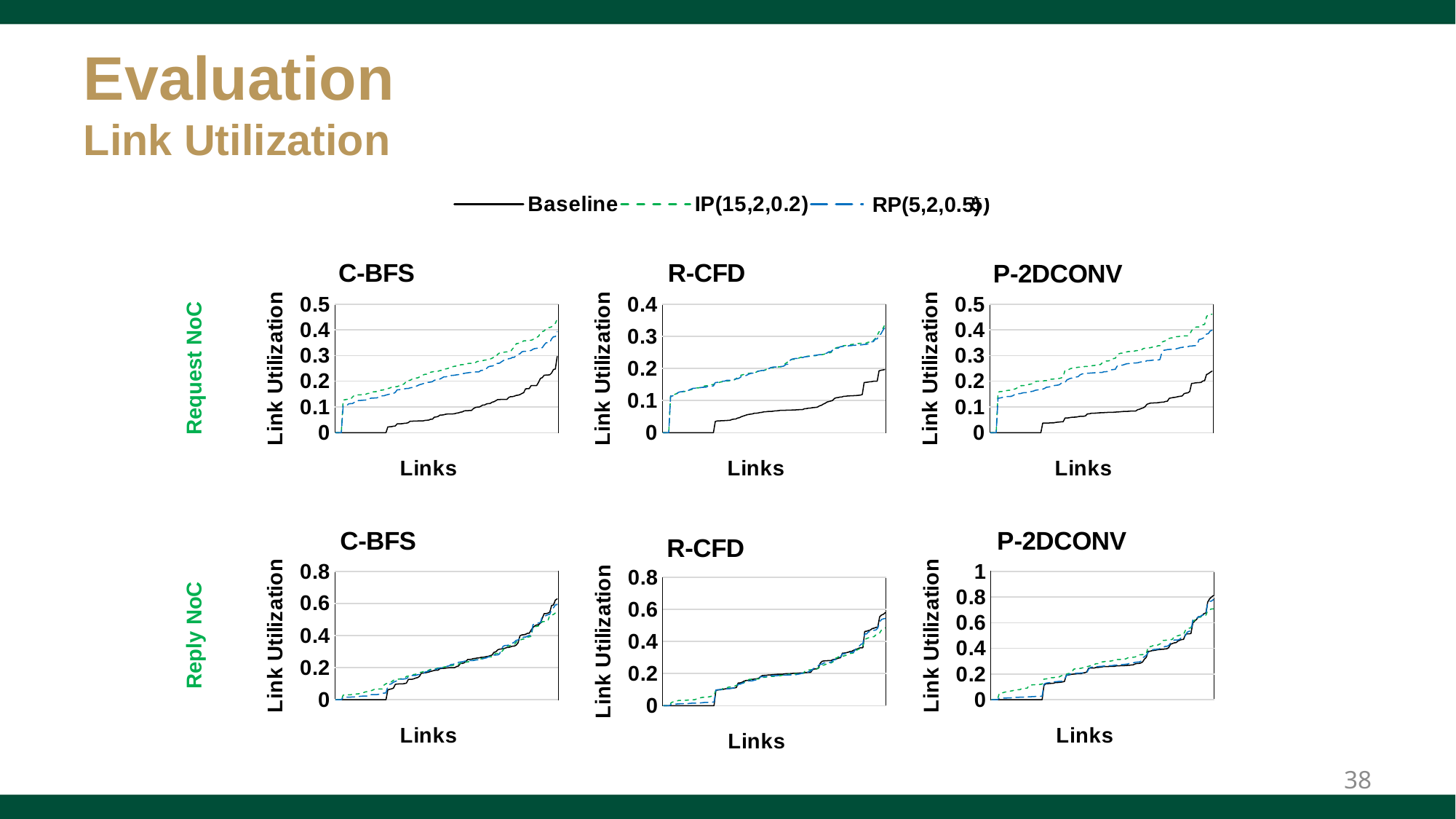
In the Reply NoC P-2DCONV chart, is the highest value reached by the Baseline line greater or less than 0.6? greater In the Request NoC C-BFS chart, does the Baseline line rise or fall along the x axis? rise In the Request NoC R-CFD chart, is the highest value reached by the Baseline line greater or less than 0.3? less What kind of chart is the Request NoC C-BFS chart? line chart In the Request NoC P-2DCONV chart, is the highest value reached by the Baseline line greater or less than 0.3? less How many charts are shown on the slide? 6 What is the y-axis label on the charts? Link Utilization How many series does the legend at the top of the slide list? 3 In the Request NoC P-2DCONV chart, does the RP(5,2,0.5) line rise or fall along the x axis? rise In the Request NoC R-CFD chart, which series reaches a higher link utilization at the rightmost link, Baseline or IP(15,2,0.2)? IP(15,2,0.2)